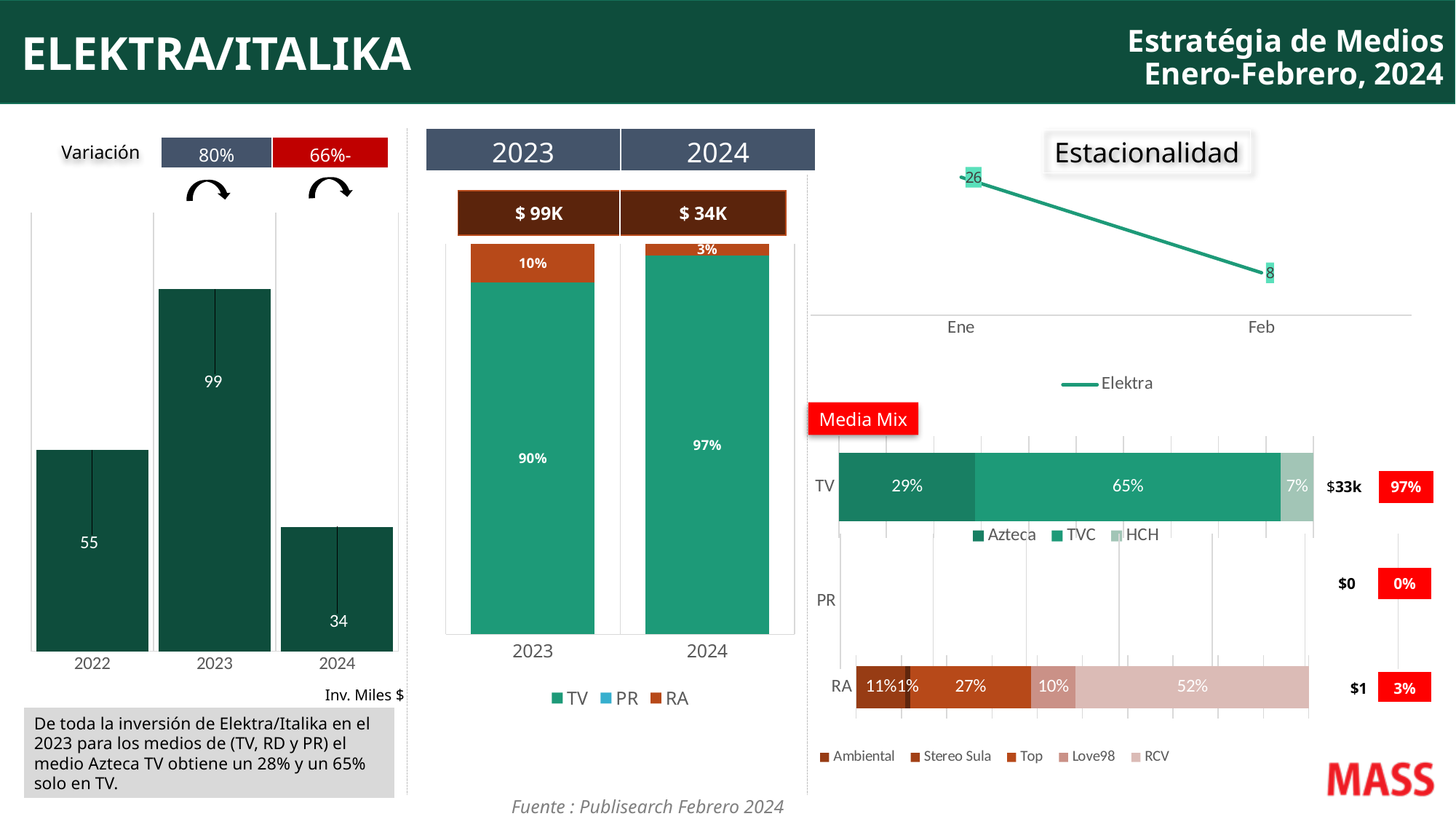
What kind of chart is the Estacionalidad chart? line chart In the left bar chart of investment by year, which year has the lowest value? 2024 In the left bar chart of investment by year, what is the difference between the 2023 and 2022 values? 44 In the Estacionalidad chart, do the values rise or fall from Ene to Feb? fall In the Media Mix chart, which station has the largest share in the RA bar? RCV In the left bar chart of investment by year, what is the value for 2023? 99 In the middle stacked bar chart comparing 2023 and 2024, what share does RA have in 2023? 10% In the Media Mix chart, what share does TVC have in the TV bar? 65% In the left bar chart of investment by year, how many years are shown? 3 In the Estacionalidad chart, what is the value for Feb? 8 In the middle stacked bar chart comparing 2023 and 2024, how many series does the legend list? 3 In the middle stacked bar chart comparing 2023 and 2024, what share does TV have in 2024? 97%